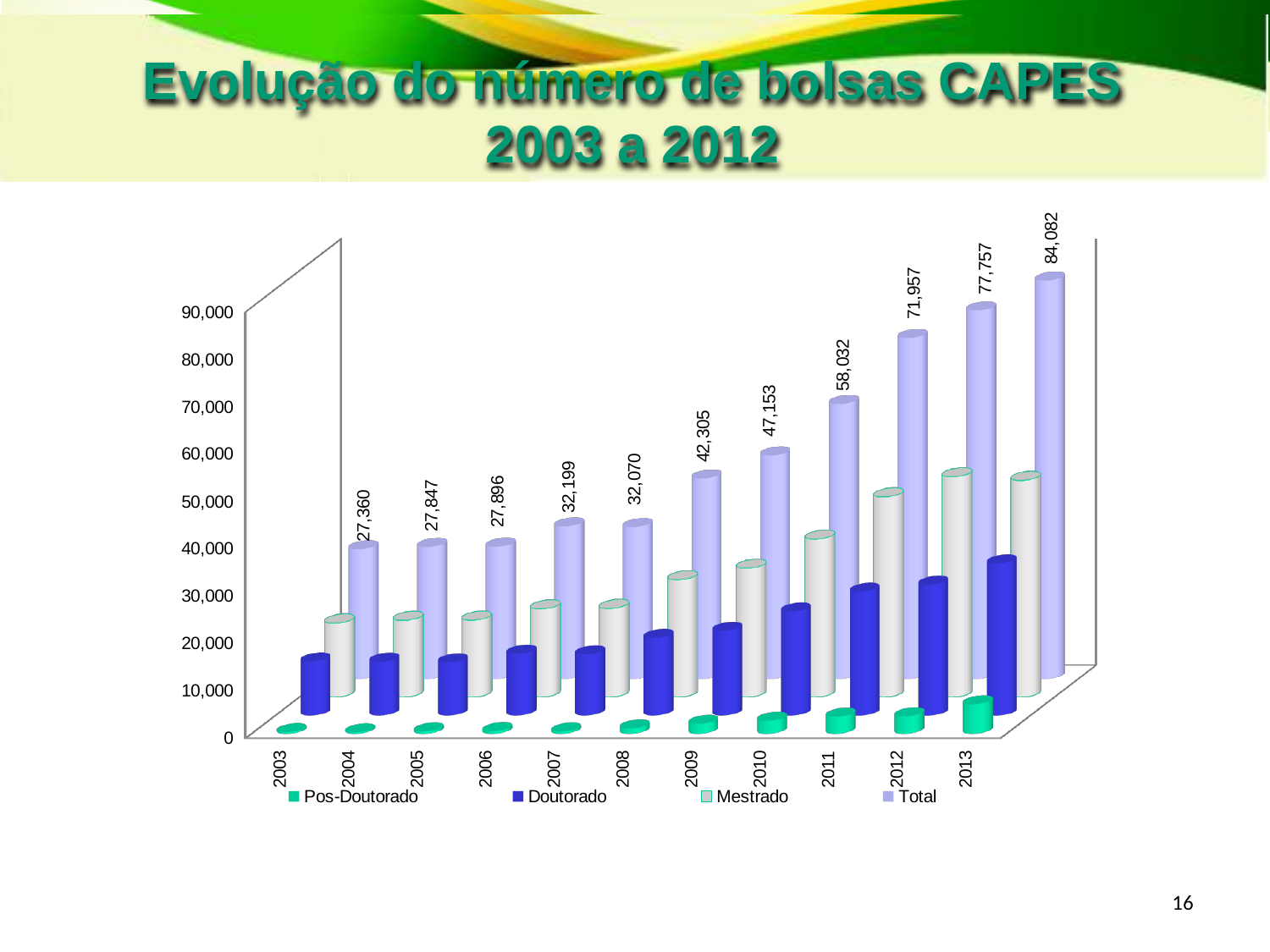
What kind of chart is shown on the slide? bar chart How many series does the legend list? 4 Which year has the highest Total value? 2013 What is the Total value for 2003? 27,360 Which is larger, the Total value for 2006 or for 2007? 2006 Which year has the lowest Total value? 2003 How many years are shown on the x axis? 11 Is the Pos-Doutorado value for 2013 greater or less than 10,000? less What is the Total value for 2013? 84,082 What is the difference between the Total values for 2013 and 2012? 6,325 Do the Total values generally rise or fall from 2003 to 2013? rise What is the Total value for 2010? 58,032